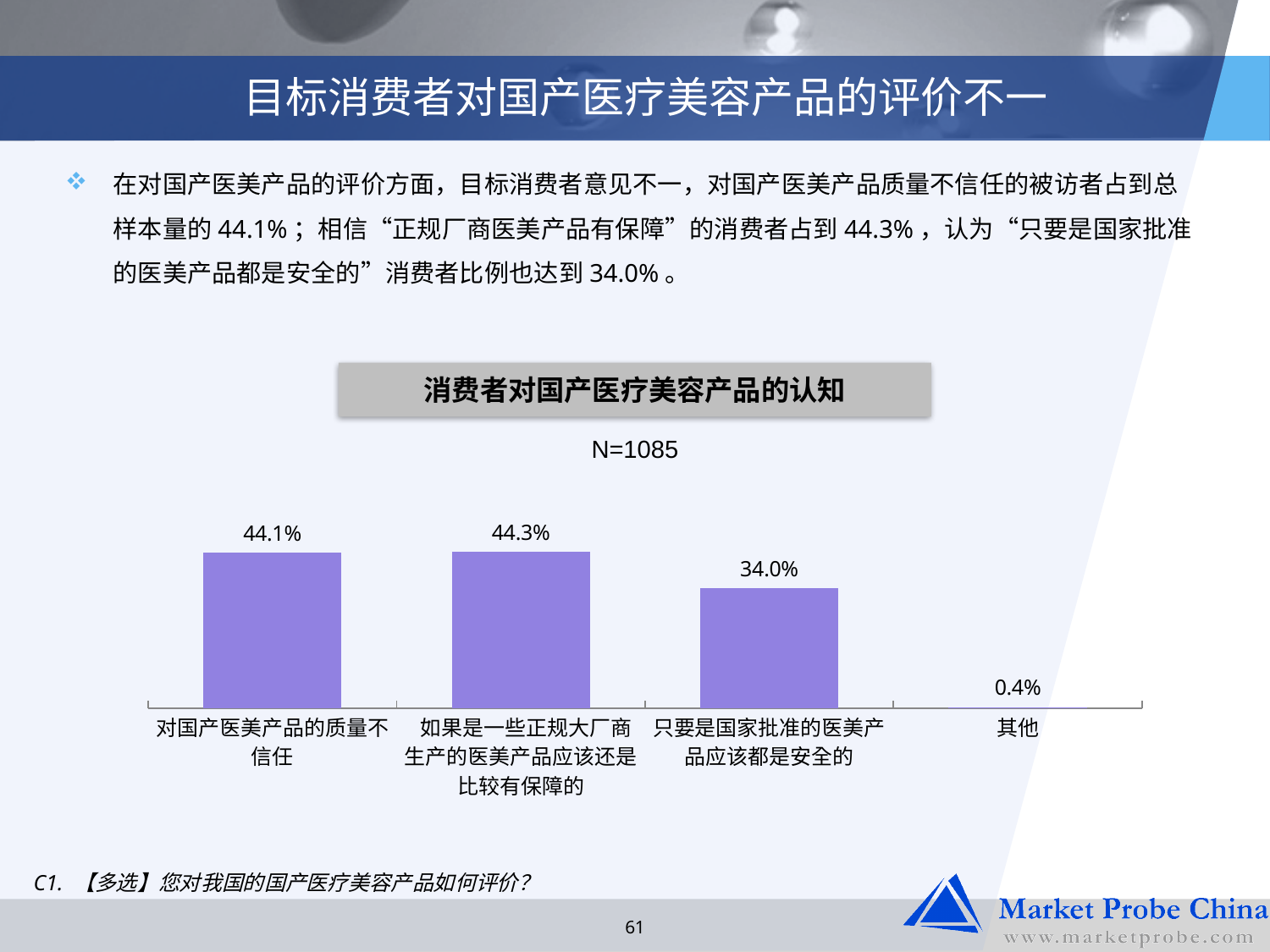
What is the difference between the values for 对国产医美产品的质量不信任 and 只要是国家批准的医美产品应该都是安全的? 10.1% What is the value for 只要是国家批准的医美产品应该都是安全的? 34.0% What is the value for 其他? 0.4% What is the sample size (N) shown for the chart? N=1085 Which is larger: the value for 对国产医美产品的质量不信任 or the value for 只要是国家批准的医美产品应该都是安全的? 对国产医美产品的质量不信任 Which category has the highest value? 如果是一些正规大厂商生产的医美产品应该还是比较有保障的 How many categories are shown in the chart? 4 Which category has the lowest value? 其他 What is the difference between the values for 如果是一些正规大厂商生产的医美产品应该还是比较有保障的 and 只要是国家批准的医美产品应该都是安全的? 10.3% What kind of chart is shown on the slide? Bar chart What is the value for 如果是一些正规大厂商生产的医美产品应该还是比较有保障的? 44.3% What is the value for 对国产医美产品的质量不信任? 44.1%